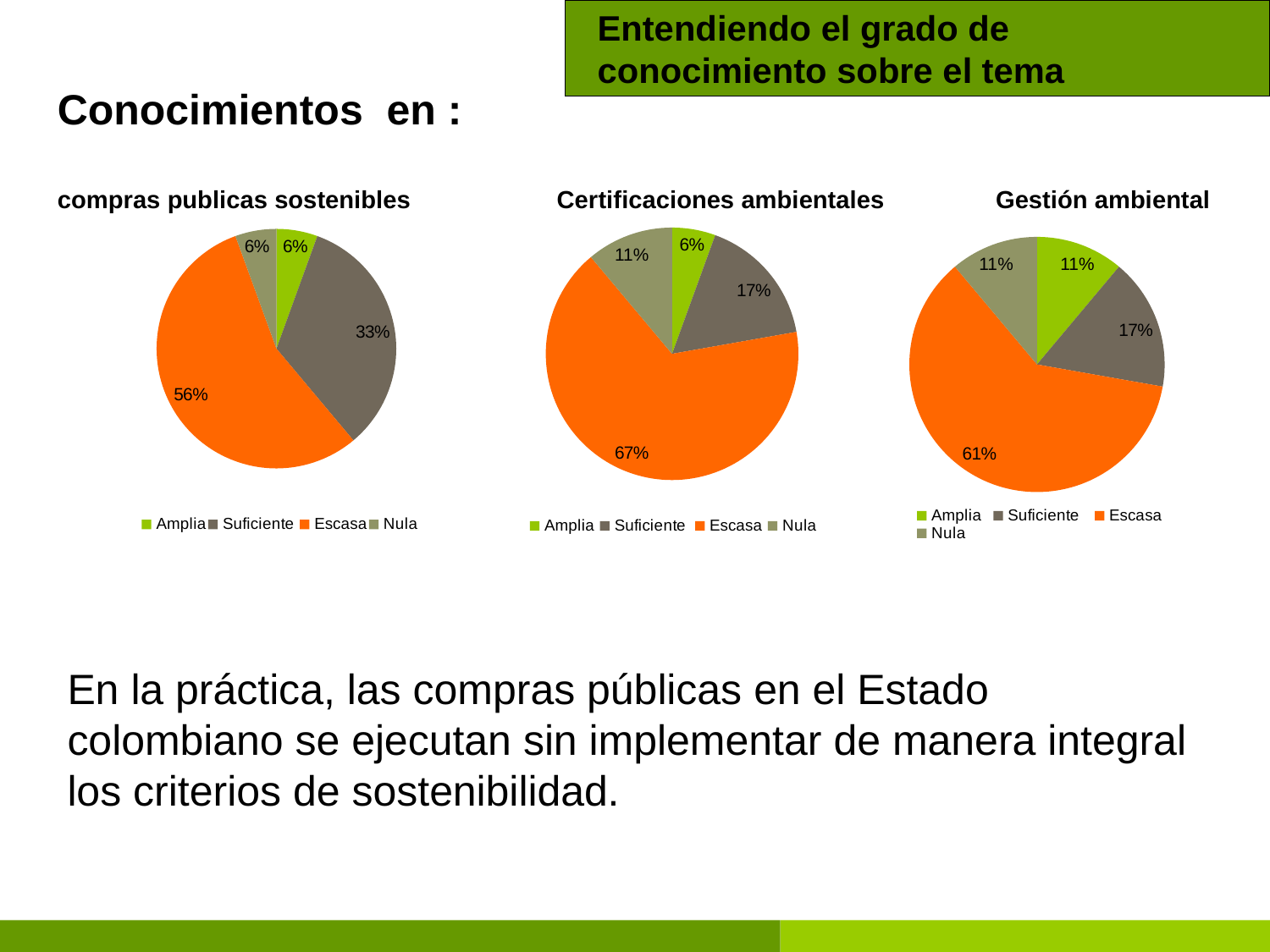
In the 'Certificaciones ambientales' pie chart, what share is labelled for Escasa? 67% In the 'Certificaciones ambientales' pie chart, what share is labelled for Nula? 11% In the 'Gestión ambiental' pie chart, what share is labelled for Suficiente? 17% In the 'compras publicas sostenibles' pie chart, what share is labelled for Escasa? 56% In the 'compras publicas sostenibles' pie chart, what is the difference between the Escasa and Suficiente shares? 23% In the 'compras publicas sostenibles' pie chart, what share is labelled for Suficiente? 33% How many categories does the legend of the 'Certificaciones ambientales' chart list? 4 How many pie charts are shown on the slide? 3 Which is larger in the 'Gestión ambiental' pie chart: the Escasa slice or the Suficiente slice? Escasa What type of chart is used for 'Gestión ambiental'? Pie chart In the 'Certificaciones ambientales' pie chart, which category has the smallest slice? Amplia In the 'Gestión ambiental' pie chart, which category has the largest slice? Escasa